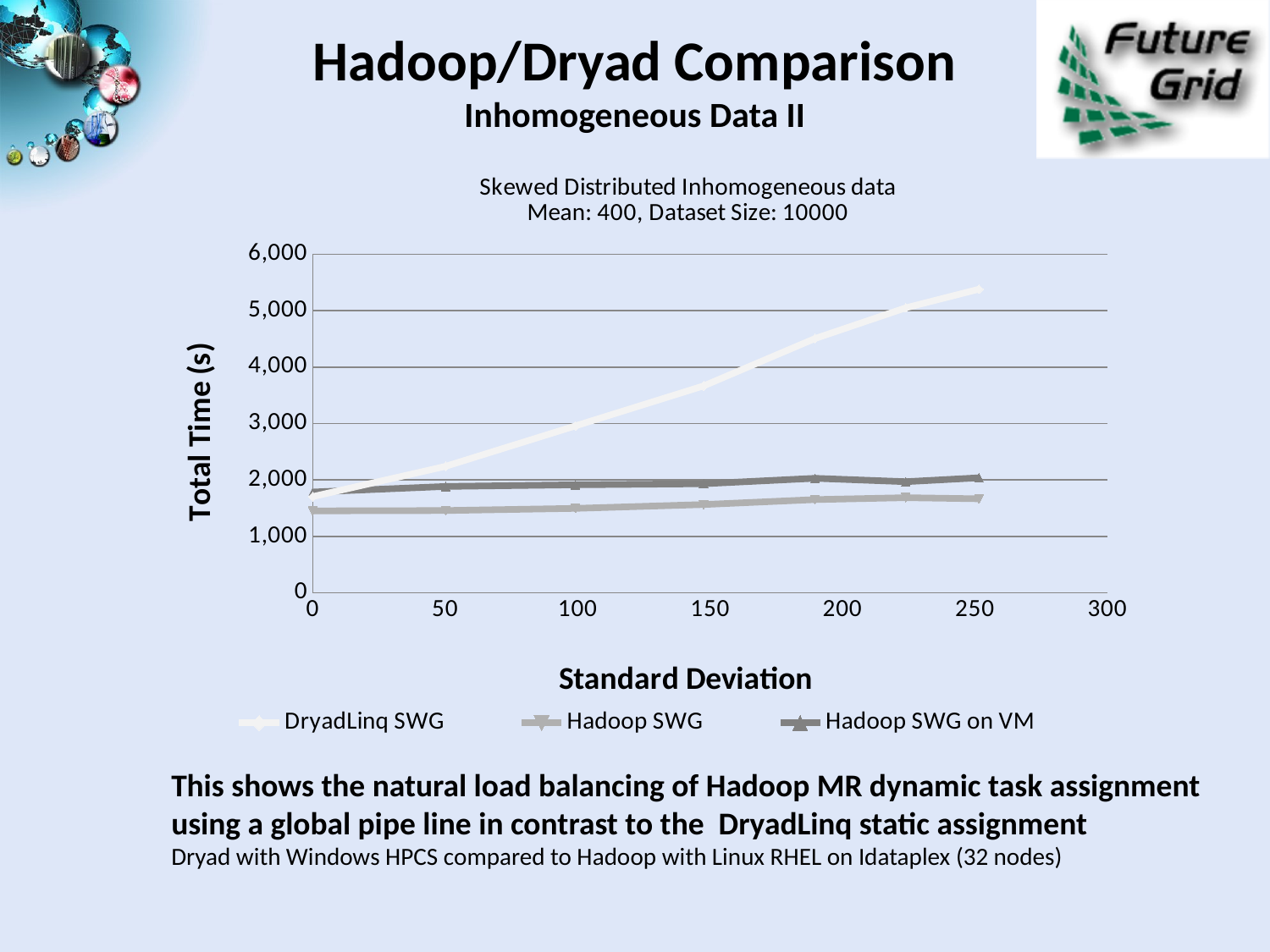
Does the DryadLinq SWG line rise or fall as Standard Deviation increases? rise Is the value for Hadoop SWG at Standard Deviation 250 greater or less than 2,000? less Is the value for DryadLinq SWG at Standard Deviation 250 greater or less than 5,000? greater What is the label of the y axis? Total Time (s) What kind of chart is shown on the slide? line chart Which series has the lowest Total Time at Standard Deviation 250? Hadoop SWG What is the title of the chart? Skewed Distributed Inhomogeneous data Mean: 400, Dataset Size: 10000 Which series has the highest Total Time at Standard Deviation 250? DryadLinq SWG Is the value for DryadLinq SWG at Standard Deviation 150 greater or less than 3,000? greater At Standard Deviation 250, which is larger: DryadLinq SWG or Hadoop SWG? DryadLinq SWG How many series does the legend list? 3